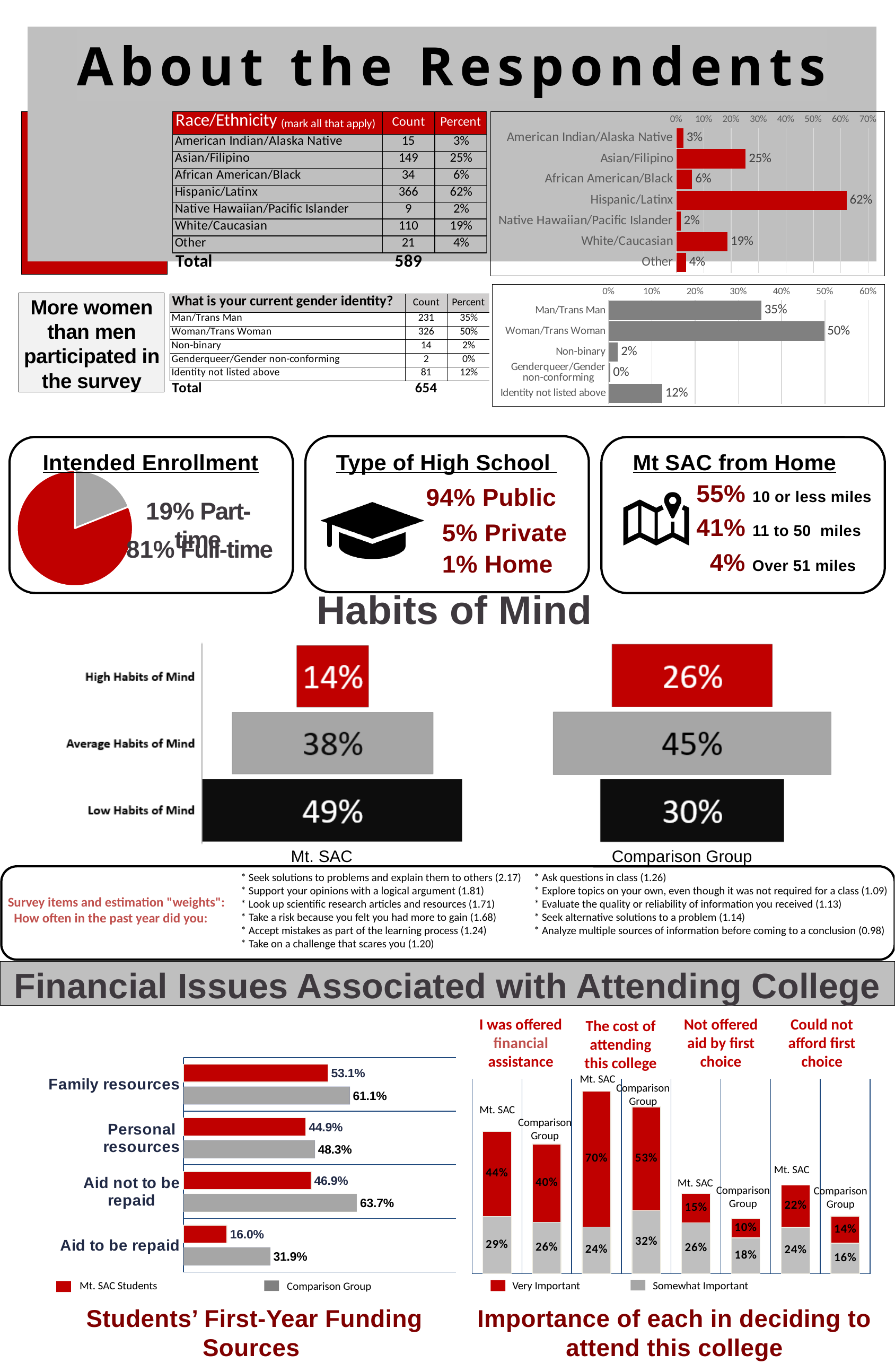
In the Habits of Mind chart, what is the Low Habits of Mind value for Mt. SAC? 49% In the Students' First-Year Funding Sources chart, what is the difference between Comparison Group and Mt. SAC Students for Aid to be repaid? 15.9% In the gender identity bar chart, what is the value for Woman/Trans Woman? 50% In the Importance of each in deciding to attend this college chart, what is the total of the Mt. SAC stacked bar for The cost of attending this college? 94% In the Intended Enrollment pie chart, what share is Full-time? 81% In the Students' First-Year Funding Sources chart, what is the Comparison Group value for Aid not to be repaid? 63.7% In the Habits of Mind chart, which is larger for High Habits of Mind: Mt. SAC or Comparison Group? Comparison Group In the Race/Ethnicity bar chart, what is the value for Hispanic/Latinx? 62% In the Race/Ethnicity bar chart, which category has the lowest value? Native Hawaiian/Pacific Islander In the Race/Ethnicity bar chart, how many categories are shown? 7 In the gender identity bar chart, what is the difference between Woman/Trans Woman and Man/Trans Man? 15% In the Importance of each in deciding to attend this college chart, how many series does the legend list? 2